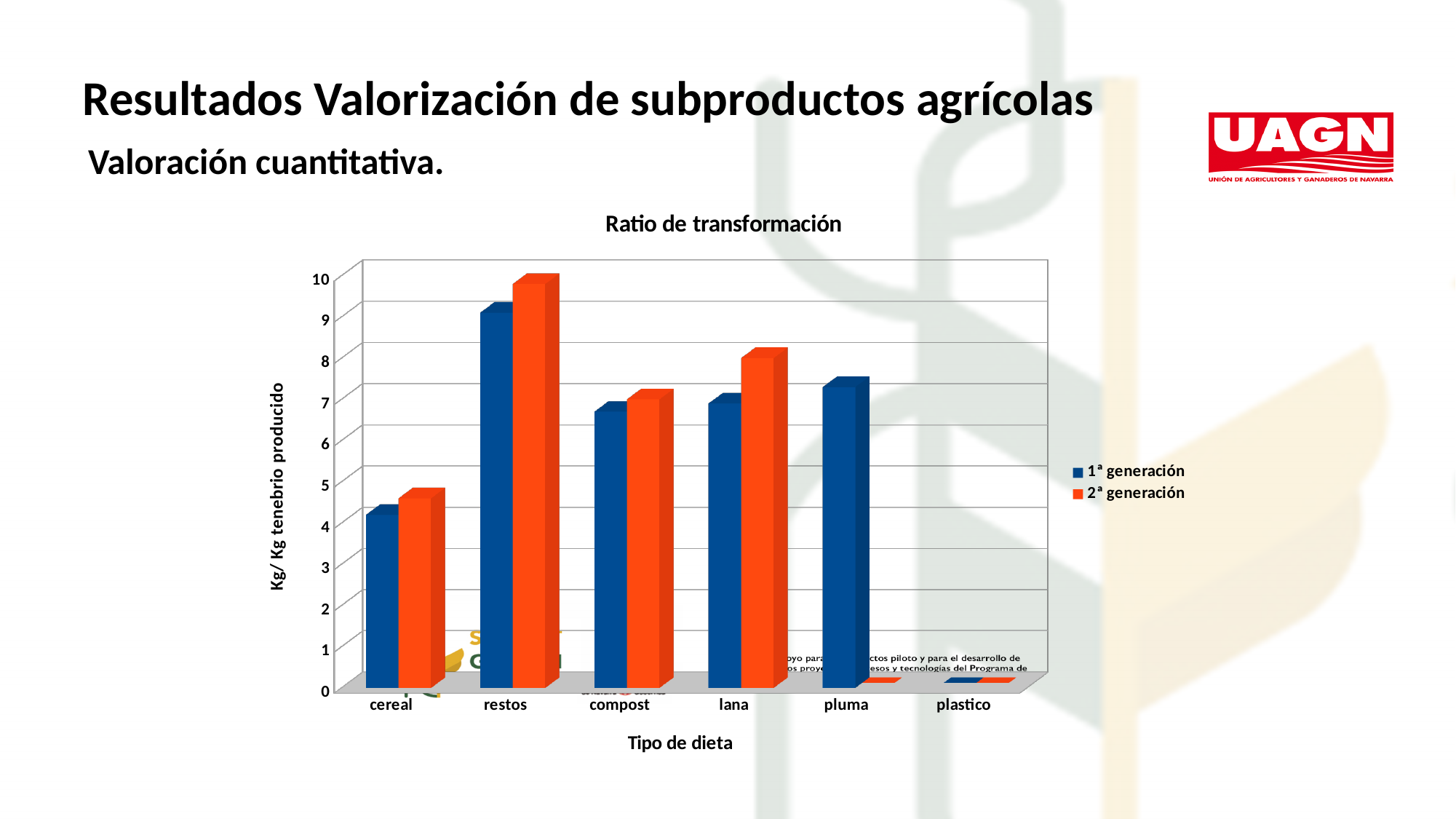
Which diet type has the highest value for 2ª generación? restos Is the 2ª generación value for lana greater or less than 7? greater Which diet type has the highest value for 1ª generación? restos What is the title of the chart? Ratio de transformación Which diet type has the lowest value for 1ª generación? plastico Is the 1ª generación value for cereal greater or less than 5? less What type of chart is shown on the slide? bar chart For 1ª generación, which is larger: restos or cereal? restos Is the 2ª generación value for restos greater or less than 9? greater How many series does the legend list? 2 What is the label of the y axis? Kg/ Kg tenebrio producido How many diet types (categories) are shown on the x axis? 6